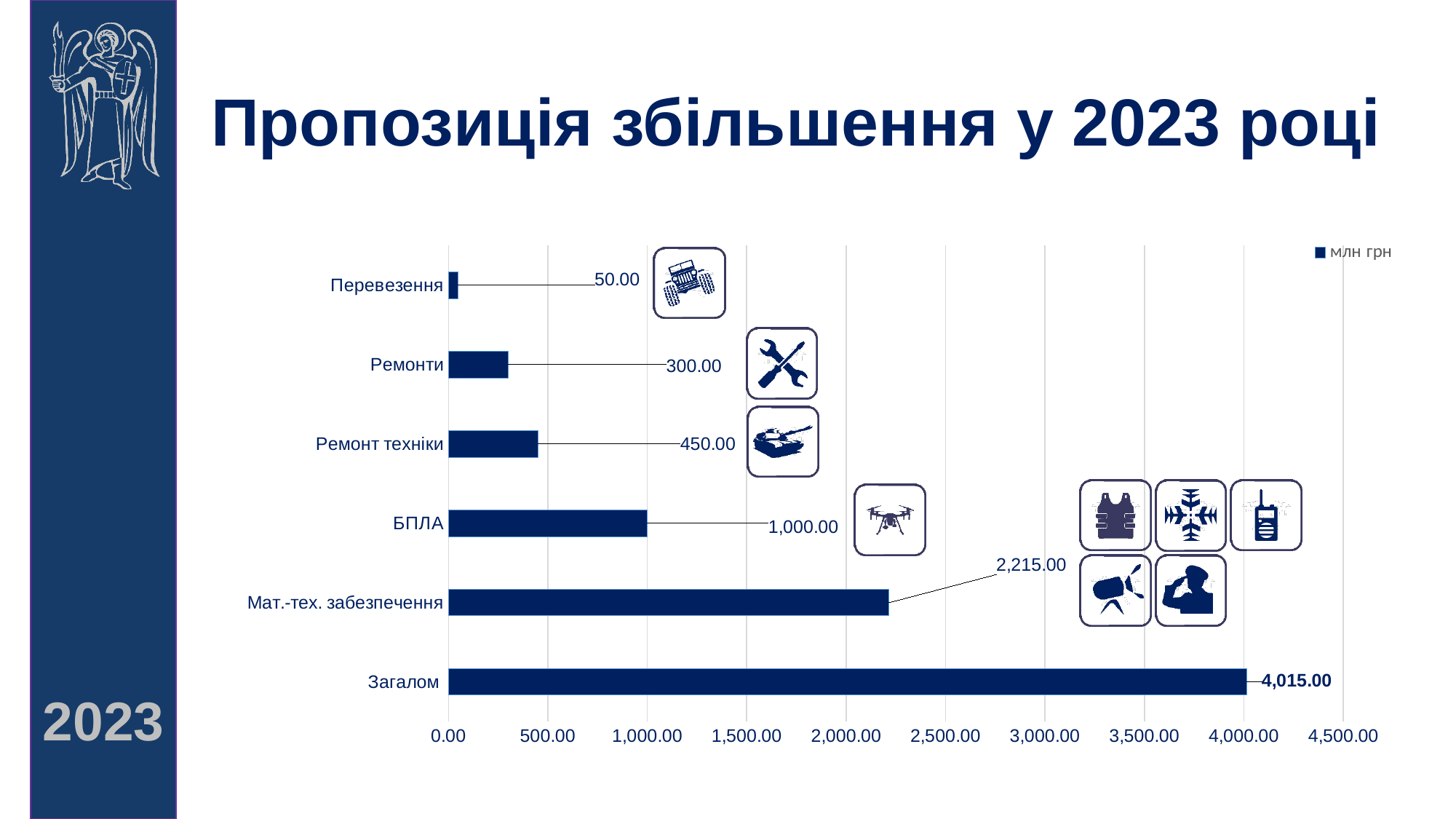
What is the value for БПЛА? 1,000.00 Which category has the lowest value? Перевезення What is the legend entry of the chart? млн грн What is the difference between the values for Ремонт техніки and Ремонти? 150.00 Which is larger, the value for БПЛА or the value for Ремонти? БПЛА What is the value for Перевезення? 50.00 Which category has the highest value? Загалом What is the value for Мат.-тех. забезпечення? 2,215.00 How many categories are shown on the chart? 6 What kind of chart is shown on the slide? Bar chart What is the value for Ремонт техніки? 450.00 How many series does the legend list? 1